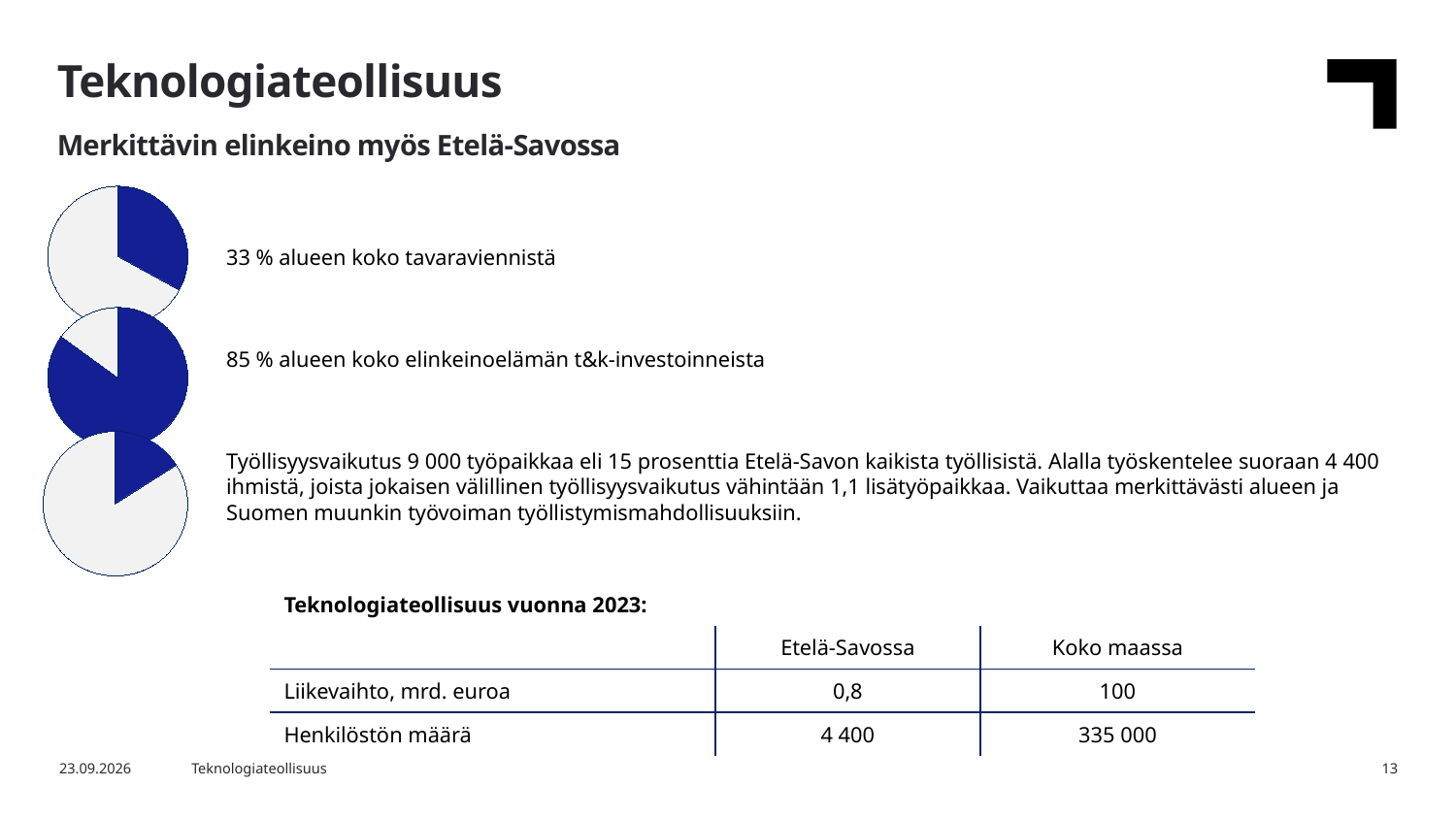
In the bottom pie chart, what share of all employed people in Etelä-Savo does the blue slice represent? 15 prosenttia Which of the three pie charts has the smallest blue slice? The bottom one (15 % of employment) In the top pie chart, what share of the region's total goods exports (tavaravienti) does the blue slice represent? 33 % Is the blue slice in the top pie chart (goods exports) larger or smaller than the blue slice in the middle pie chart (R&D investments)? Smaller In the top pie chart, is the blue slice greater or less than 50 % of the pie? less In the middle pie chart, what share of the region's business R&D investments (t&k-investoinnit) does the blue slice represent? 85 % How many pie charts are on the slide? 3 How many slices does each pie chart have? 2 In the middle pie chart, is the blue slice greater or less than 50 % of the pie? greater Which of the three pie charts has the largest blue slice? The middle one (85 % of R&D investments) What colour is used for the highlighted slice in each pie chart? Dark blue What kind of charts are shown on the left side of the slide? Pie charts